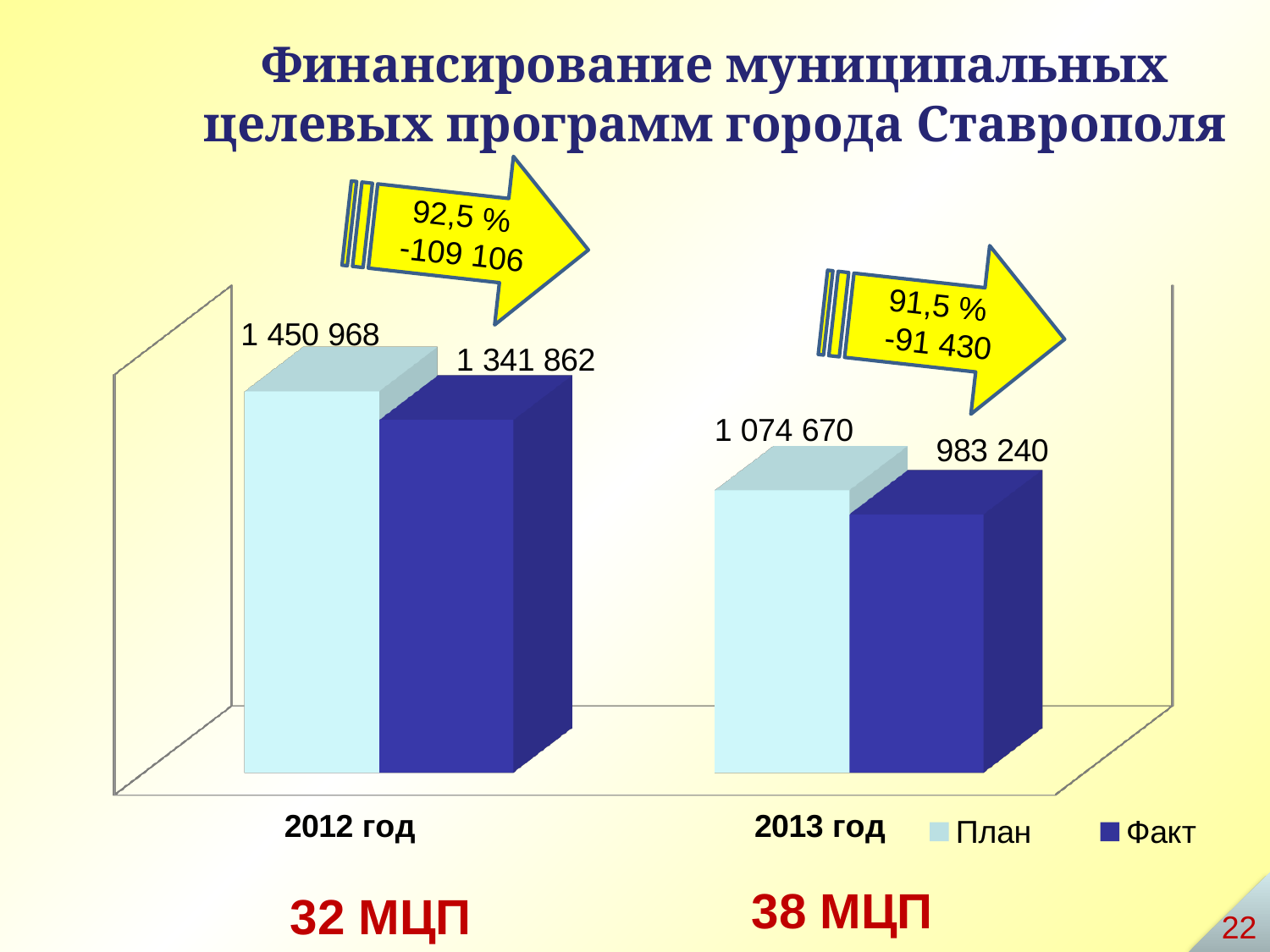
Which bar on the chart has the lowest value? Факт for 2013 год What kind of chart is shown on the slide? Bar chart What is the difference between План and Факт for 2012 год? 109 106 What is the Факт value for 2012 год? 1 341 862 What is the Факт value for 2013 год? 983 240 Which is larger for 2013 год, План or Факт? План How many categories (years) are shown on the chart? 2 What is the План value for 2012 год? 1 450 968 How many series does the legend list? 2 What is the План value for 2013 год? 1 074 670 What is the difference between План and Факт for 2013 год? 91 430 Which year has the higher Факт value? 2012 год